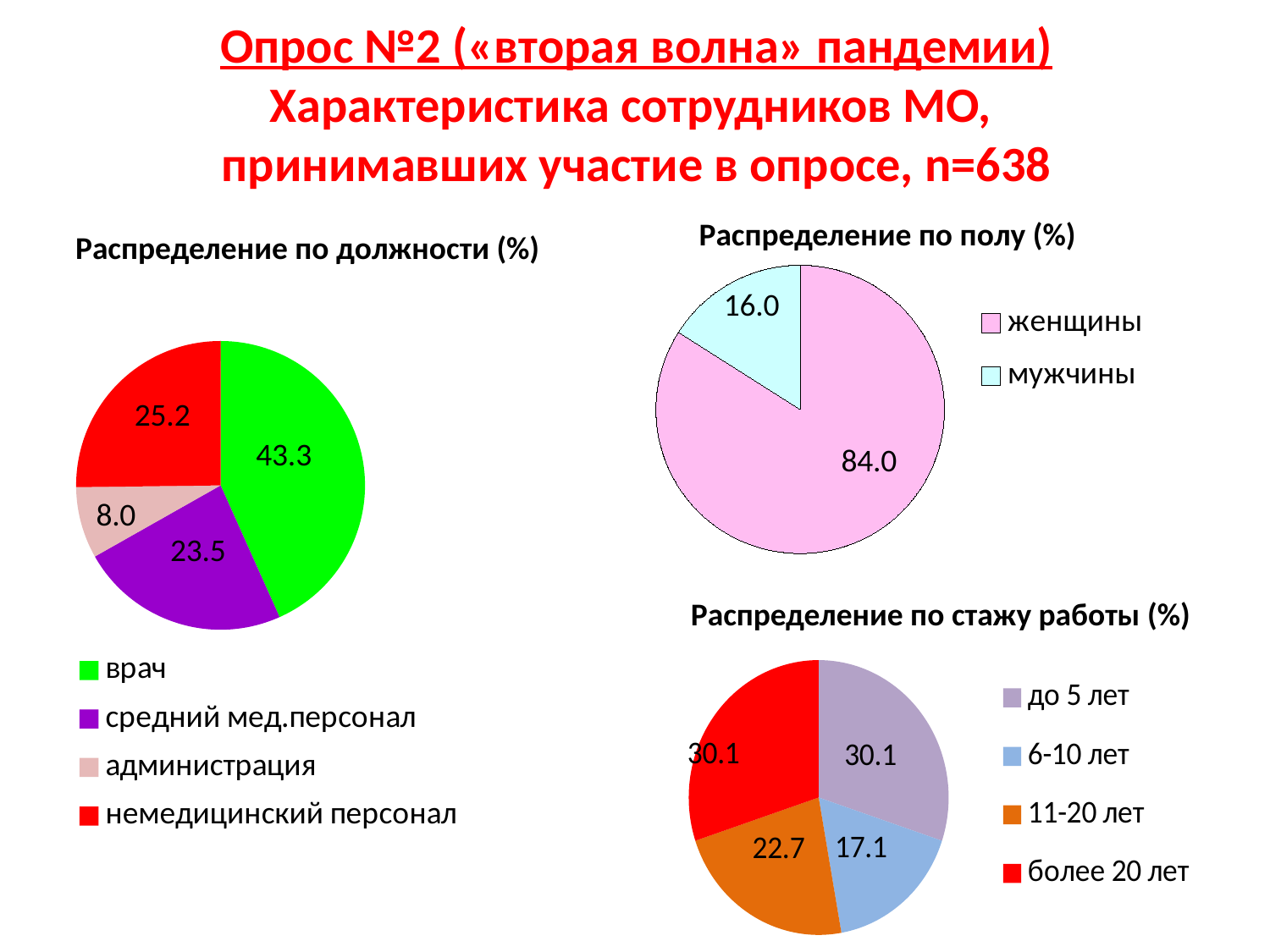
In the chart 'Распределение по полу (%)', what is the difference between the values for 'женщины' and 'мужчины'? 68.0 In the chart 'Распределение по полу (%)', which is larger, 'женщины' or 'мужчины'? женщины In the chart 'Распределение по стажу работы (%)', which category has the smallest share? 6-10 лет In the chart 'Распределение по стажу работы (%)', what is the value for '11-20 лет'? 22.7 In the chart 'Распределение по должности (%)', which category has the smallest share? администрация In the chart 'Распределение по должности (%)', what is the value for 'врач'? 43.3 In the chart 'Распределение по полу (%)', what is the value for 'мужчины'? 16.0 In the chart 'Распределение по должности (%)', which category has the largest share? врач In the chart 'Распределение по должности (%)', what is the difference between the values for 'немедицинский персонал' and 'средний мед.персонал'? 1.7 In the chart 'Распределение по должности (%)', how many categories does the legend list? 4 How many charts are shown on the slide? 3 What type of chart is 'Распределение по стажу работы (%)'? pie chart